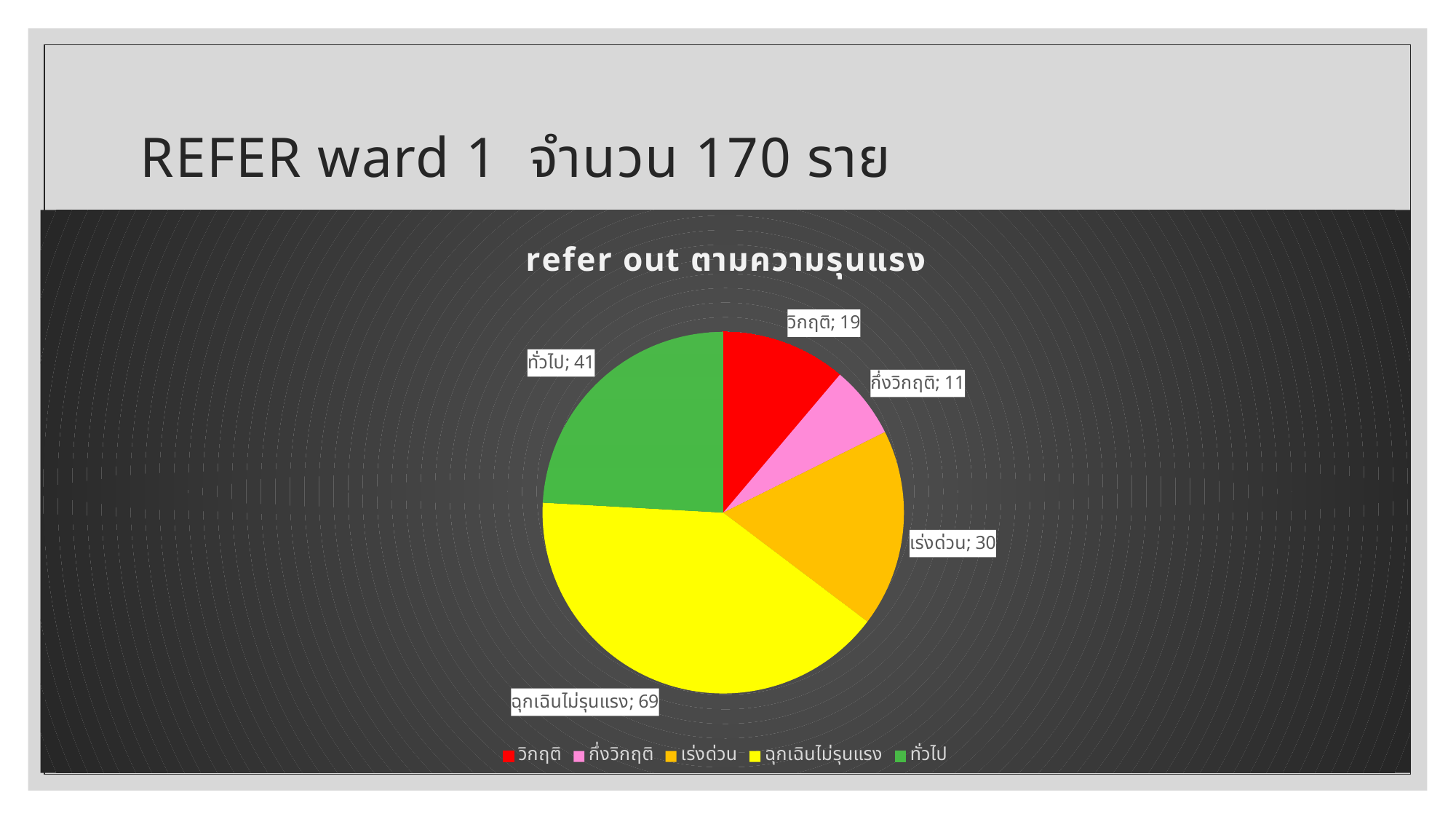
How many categories does the pie chart have? 5 What kind of chart is shown on the slide? pie chart What is the difference between the values for ฉุกเฉินไม่รุนแรง and ทั่วไป? 28 What is the title of the chart? refer out ตามความรุนแรง Which is larger, the value for เร่งด่วน or the value for วิกฤติ? เร่งด่วน What colour is the slice for เร่งด่วน? orange What is the value for วิกฤติ in the pie chart? 19 What is the value for ฉุกเฉินไม่รุนแรง in the pie chart? 69 Which category has the largest slice in the pie chart? ฉุกเฉินไม่รุนแรง What is the value for เร่งด่วน in the pie chart? 30 What is the value for ทั่วไป in the pie chart? 41 Which category has the smallest slice in the pie chart? กึ่งวิกฤติ